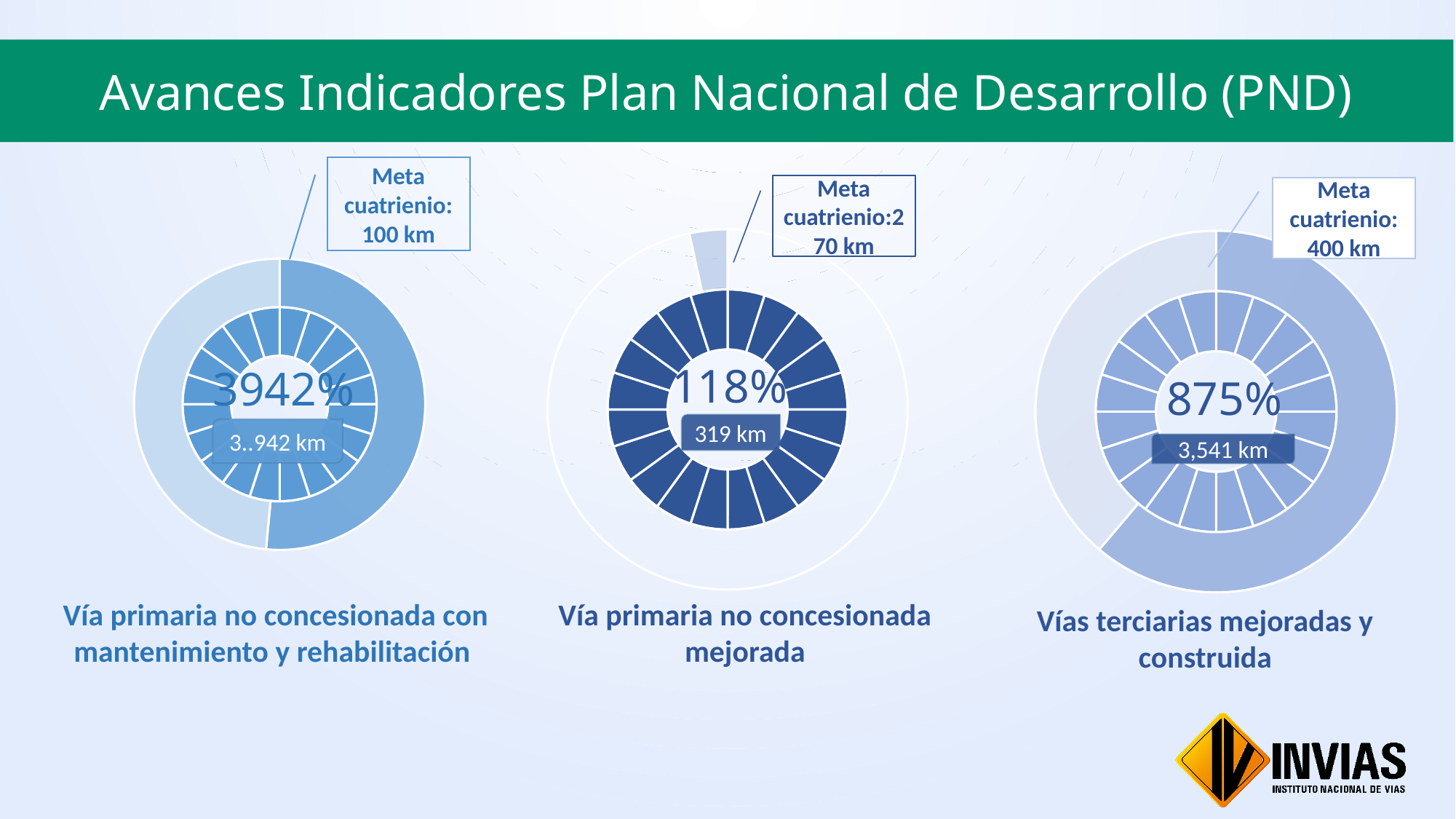
How many km are shown for 'Vías terciarias mejoradas y construida'? 3,541 km How many km are shown for 'Vía primaria no concesionada mejorada'? 319 km What percentage is shown in the centre of the 'Vía primaria no concesionada mejorada' chart? 118% How many indicator charts are shown on the slide? 3 What percentage is shown in the centre of the 'Vía primaria no concesionada con mantenimiento y rehabilitación' chart? 3942% Which of the three indicators shows the lowest percentage of progress? Vía primaria no concesionada mejorada Which has more km achieved: 'Vías terciarias mejoradas y construida' or 'Vía primaria no concesionada mejorada'? Vías terciarias mejoradas y construida What is the 'Meta cuatrienio' for 'Vías terciarias mejoradas y construida'? 400 km What is the 'Meta cuatrienio' for 'Vía primaria no concesionada con mantenimiento y rehabilitación'? 100 km Which of the three indicators shows the highest percentage of progress? Vía primaria no concesionada con mantenimiento y rehabilitación What percentage is shown in the centre of the 'Vías terciarias mejoradas y construida' chart? 875% What is the difference between the 'Meta cuatrienio' for 'Vías terciarias mejoradas y construida' and that for 'Vía primaria no concesionada con mantenimiento y rehabilitación'? 300 km